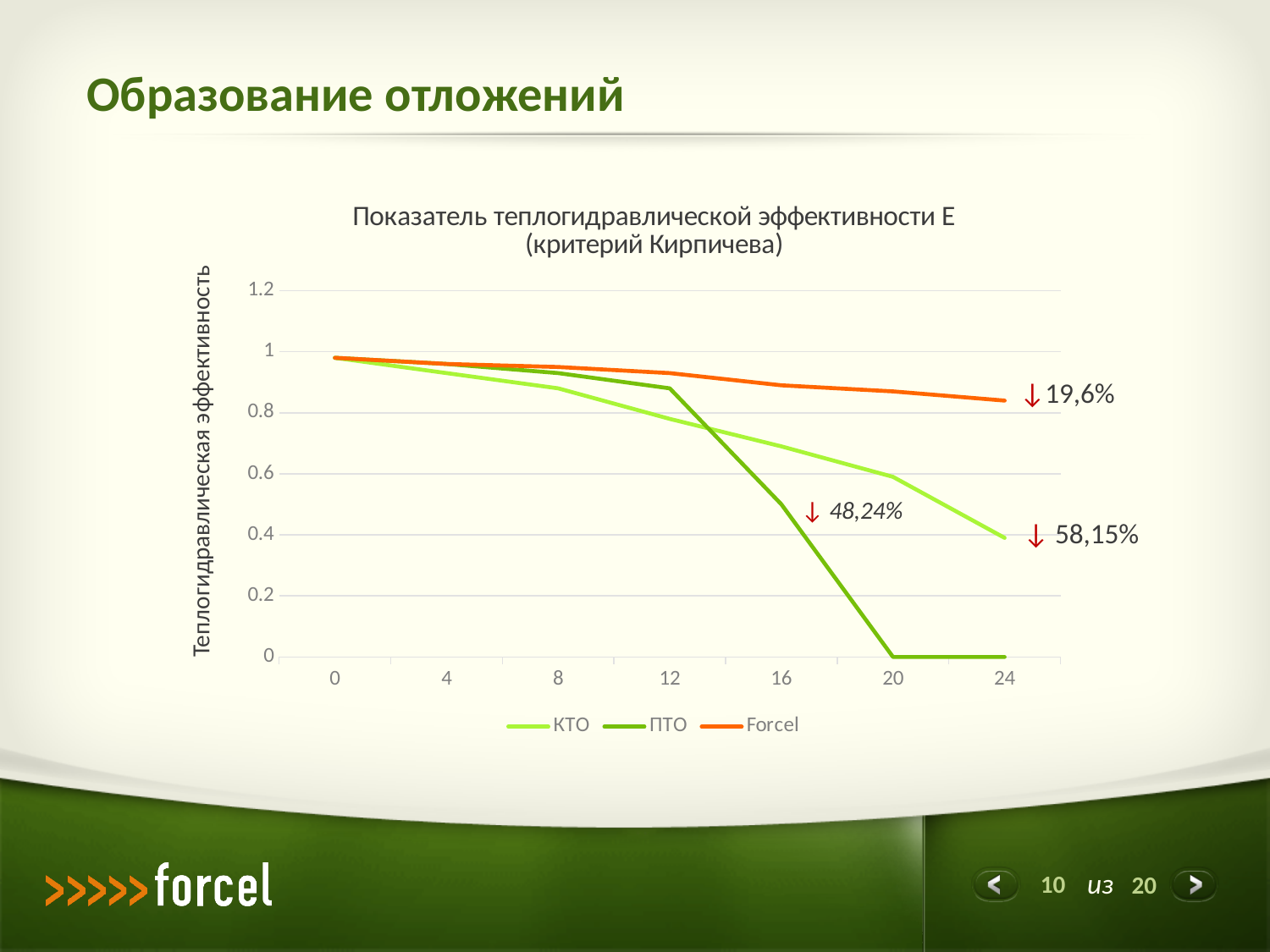
What kind of chart is shown on the slide? line chart What percentage decrease is annotated next to the ПТО line? 48,24% What percentage decrease is annotated next to the КТО line? 58,15% Which series has the lowest value at x = 24? ПТО What is the value of the ПТО series at x = 20? 0 How many series does the legend list? 3 Which series has the highest value at x = 24? Forcel Do the values of the Forcel series rise or fall along the x axis? fall Which series are listed in the legend? КТО, ПТО, Forcel What is the value of the ПТО series at x = 24? 0 What is the title of the chart? Показатель теплогидравлической эффективности E (критерий Кирпичева) What percentage decrease is annotated next to the Forcel line? 19,6%